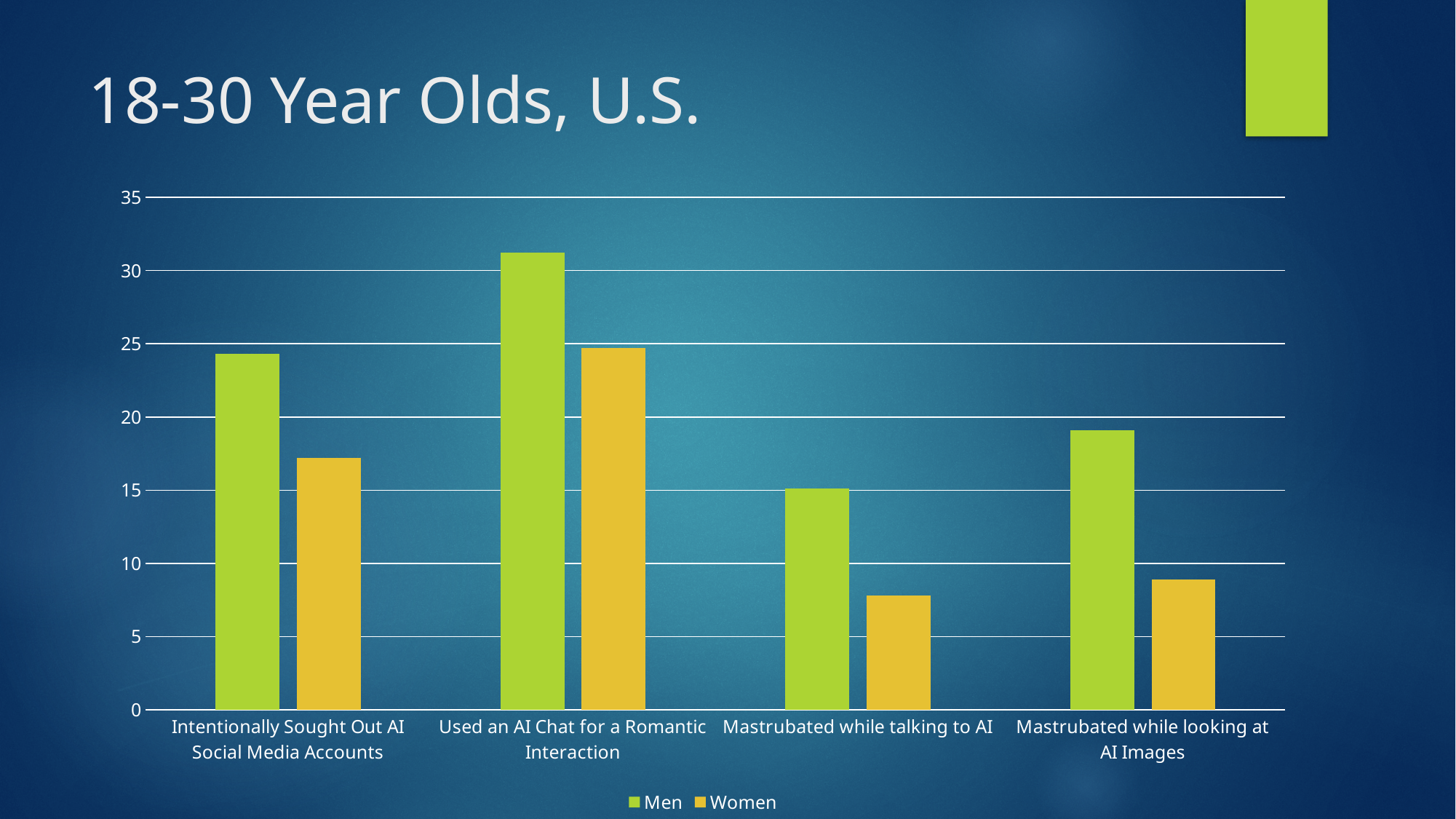
Is the value for Men in 'Intentionally Sought Out AI Social Media Accounts' greater or less than 20? greater Which category has the lowest value for Women? Mastrubated while talking to AI Which colour represents the Women series in the chart? yellow Which category has the highest value for Men? Used an AI Chat for a Romantic Interaction How many series does the legend list? 2 Is the value for Men in 'Used an AI Chat for a Romantic Interaction' greater or less than 30? greater Which is larger: the Men value or the Women value for 'Mastrubated while looking at AI Images'? Men What is the title of the slide containing the chart? 18-30 Year Olds, U.S. How many categories are shown on the x axis? 4 Which category has the lowest value for Men? Mastrubated while talking to AI What kind of chart is shown on the slide? bar chart Is the value for Women in 'Mastrubated while talking to AI' greater or less than 10? less